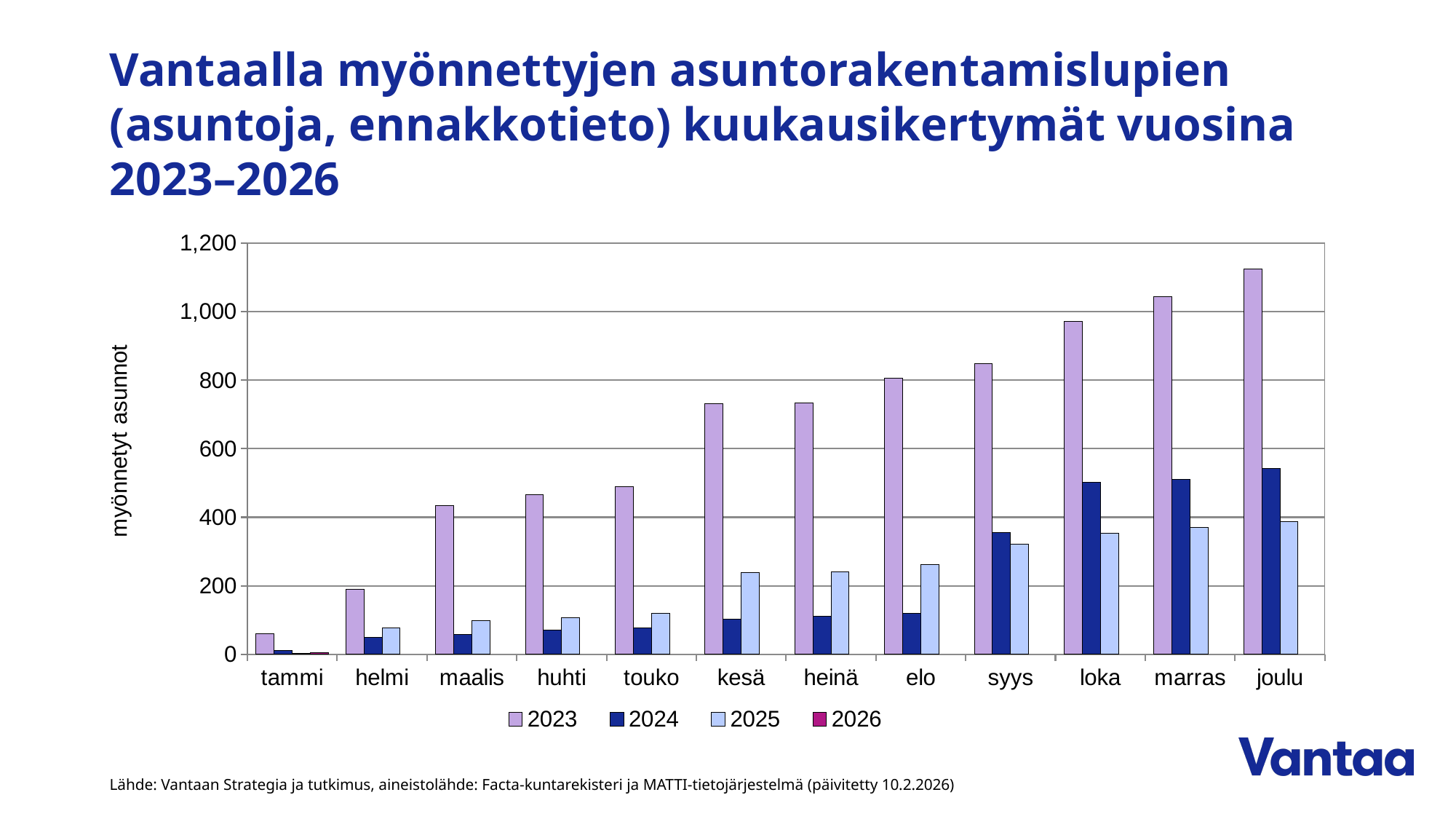
In which month is the 2023 value lowest? tammi Is the 2023 value for joulu greater or less than 1,000? greater Is the 2023 value for loka greater or less than 800? greater In which month is the 2023 value highest? joulu For kesä, which series has the larger value, 2024 or 2025? 2025 How many series does the legend list? 4 What kind of chart is shown on the slide? bar chart Is the 2024 value for joulu greater or less than 600? less How many months are shown on the x axis? 12 Do the 2023 values rise or fall from tammi to joulu? rise For loka, which series has the larger value, 2024 or 2025? 2024